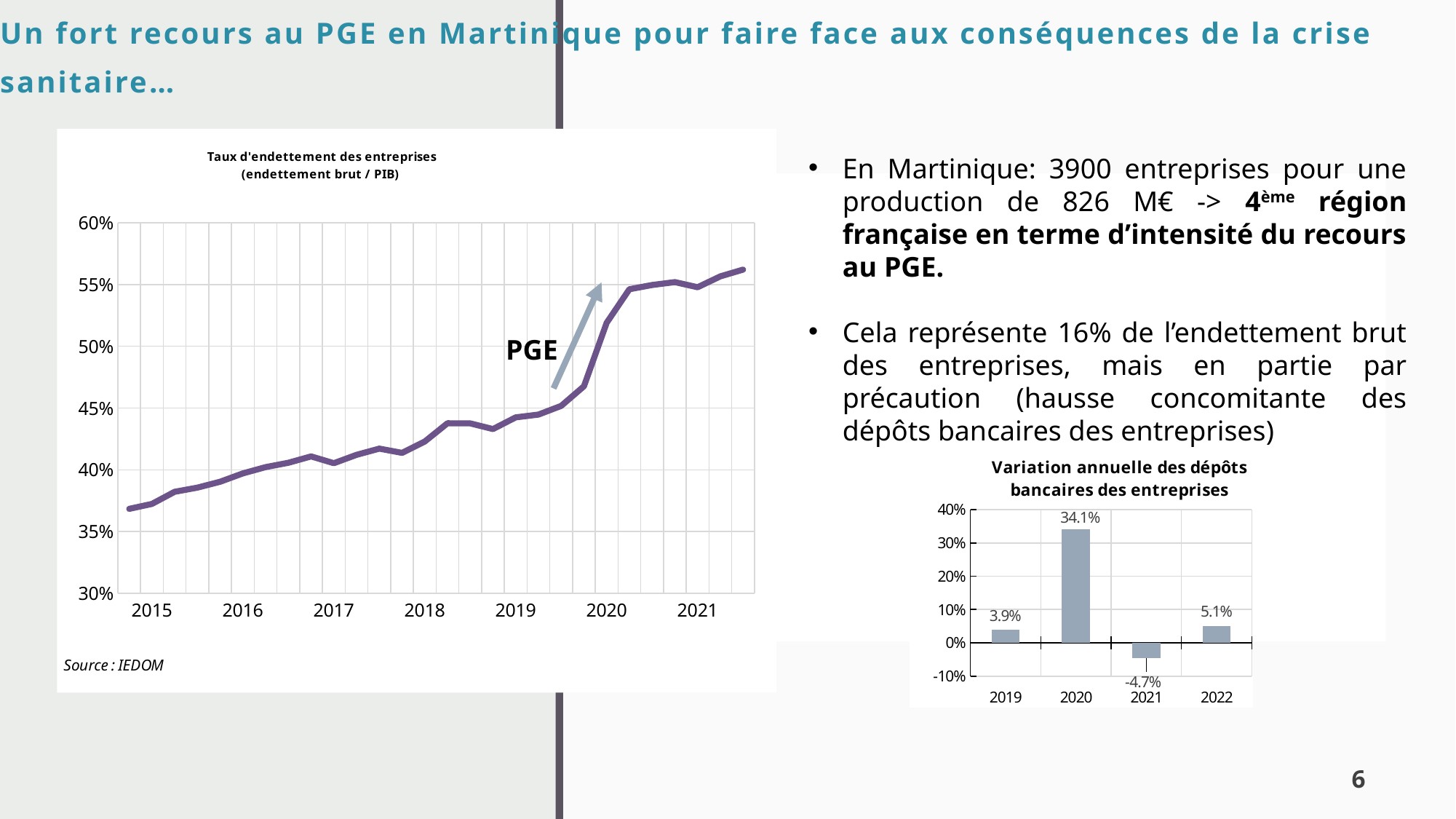
In the chart 'Variation annuelle des dépôts bancaires des entreprises', what is the difference between the 2020 value and the 2019 value? 30.2 percentage points What kind of chart is 'Variation annuelle des dépôts bancaires des entreprises'? Bar chart In the chart 'Variation annuelle des dépôts bancaires des entreprises', what is the value for 2021? -4.7% In the chart 'Variation annuelle des dépôts bancaires des entreprises', which is larger, the value for 2022 or the value for 2019? 2022 In the chart 'Variation annuelle des dépôts bancaires des entreprises', which year has the lowest value? 2021 How many years are shown in the chart 'Variation annuelle des dépôts bancaires des entreprises'? 4 In the chart 'Taux d'endettement des entreprises', is the last value shown in 2021 greater or less than 55%? greater In the chart 'Variation annuelle des dépôts bancaires des entreprises', which year has the highest value? 2020 In the chart 'Variation annuelle des dépôts bancaires des entreprises', what is the value for 2020? 34.1% In the chart 'Variation annuelle des dépôts bancaires des entreprises', what is the value for 2019? 3.9% In the chart 'Taux d'endettement des entreprises', is the value at the start of 2015 greater or less than 40%? less What kind of chart is 'Taux d'endettement des entreprises (endettement brut / PIB)'? Line chart